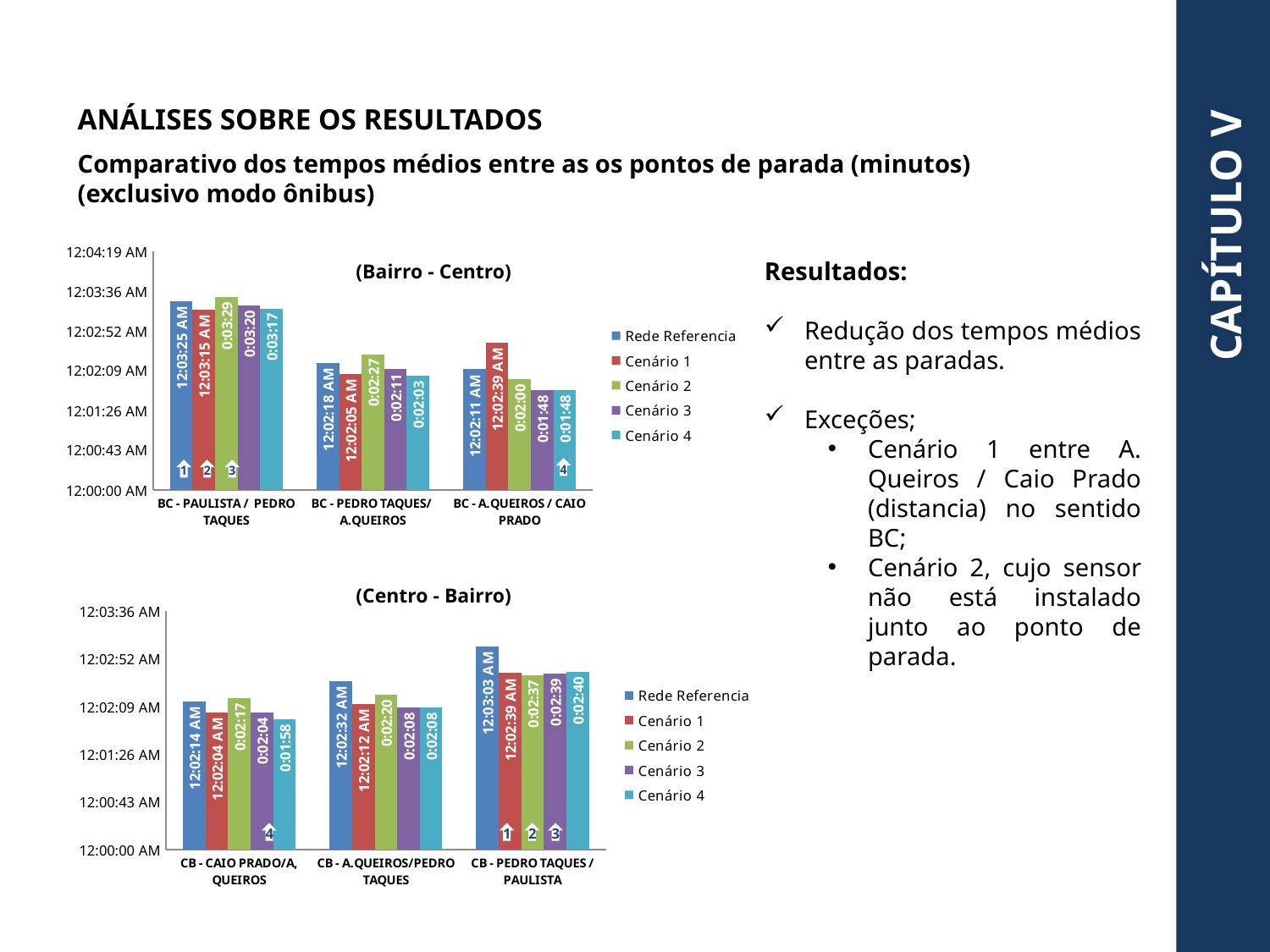
In the (Centro - Bairro) chart, which series has the lowest value for CB - CAIO PRADO/A, QUEIROS? Cenário 4 In the (Bairro - Centro) chart, what is the Rede Referencia value for BC - PEDRO TAQUES/ A.QUEIROS? 12:02:18 AM What kind of chart is the (Centro - Bairro) chart? Bar chart In the (Centro - Bairro) chart, what is the Cenário 3 value for CB - A.QUEIROS/PEDRO TAQUES? 0:02:08 In the (Bairro - Centro) chart, what is the Cenário 4 value for BC - A.QUEIROS / CAIO PRADO? 0:01:48 How many categories are shown on the x axis of the (Centro - Bairro) chart? 3 In the (Centro - Bairro) chart, is the Cenário 2 value for CB - PEDRO TAQUES / PAULISTA larger or smaller than the Cenário 2 value for CB - A.QUEIROS/PEDRO TAQUES? Larger In the (Bairro - Centro) chart, what is the Cenário 2 value for BC - PAULISTA / PEDRO TAQUES? 0:03:29 In the (Bairro - Centro) chart, which series has the highest value for BC - A.QUEIROS / CAIO PRADO? Cenário 1 How many series does the legend of the (Bairro - Centro) chart list? 5 In the (Centro - Bairro) chart, what is the Cenário 4 value for CB - CAIO PRADO/A, QUEIROS? 0:01:58 In the (Centro - Bairro) chart, what is the Rede Referencia value for CB - PEDRO TAQUES / PAULISTA? 12:03:03 AM